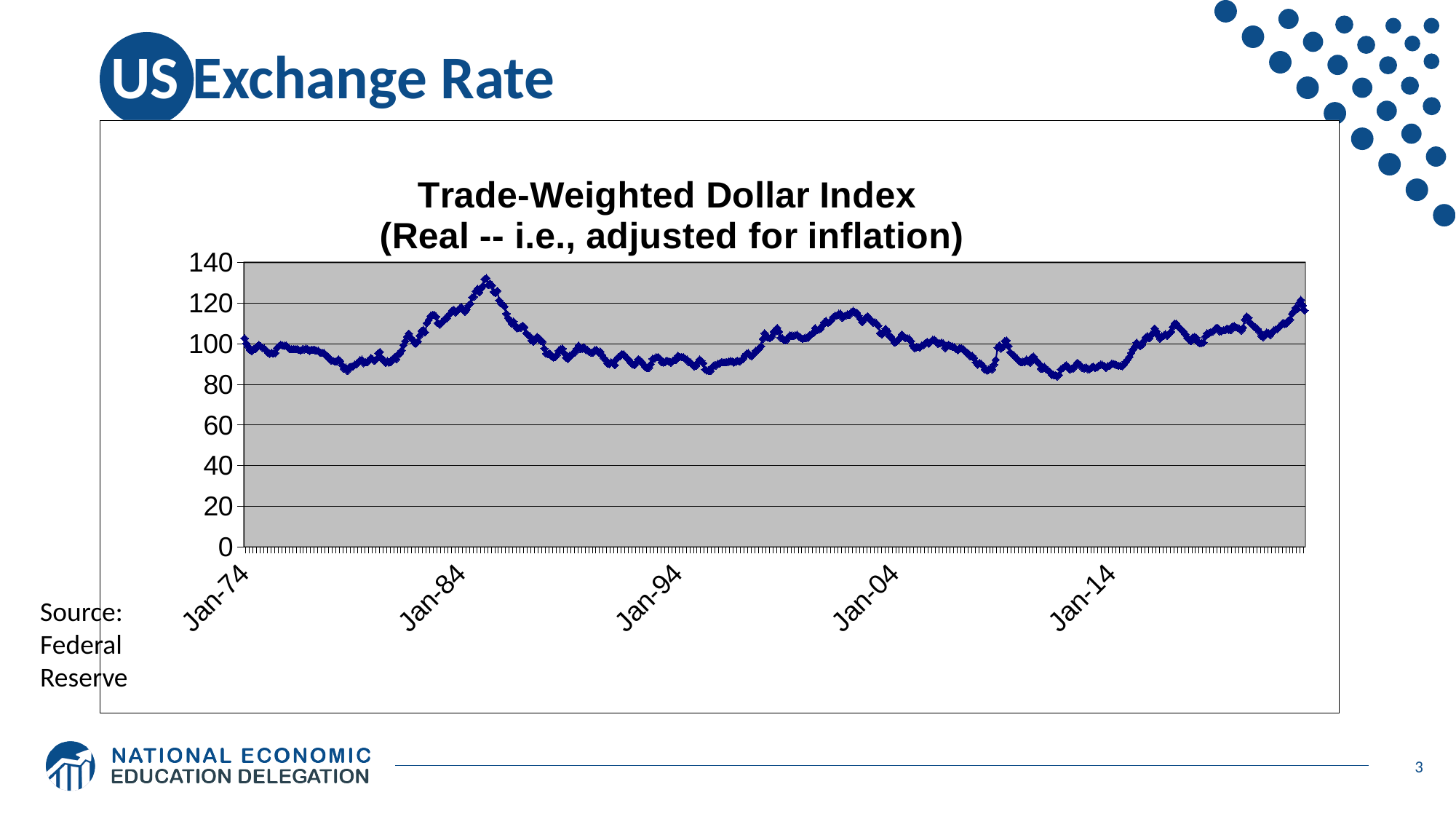
Is the value of the Trade-Weighted Dollar Index at Jan-84 greater or less than 100? greater Is the value of the Trade-Weighted Dollar Index at Jan-94 greater or less than 100? less What is the title of the chart? Trade-Weighted Dollar Index (Real -- i.e., adjusted for inflation) Is the value of the Trade-Weighted Dollar Index at Jan-74 greater or less than 80? greater How many date labels are shown on the horizontal axis of the chart? 5 Does the Trade-Weighted Dollar Index rise or fall between its peak in the mid-1980s and Jan-94? fall What is the highest value shown on the vertical axis of the chart? 140 What kind of chart is shown on the slide? line chart